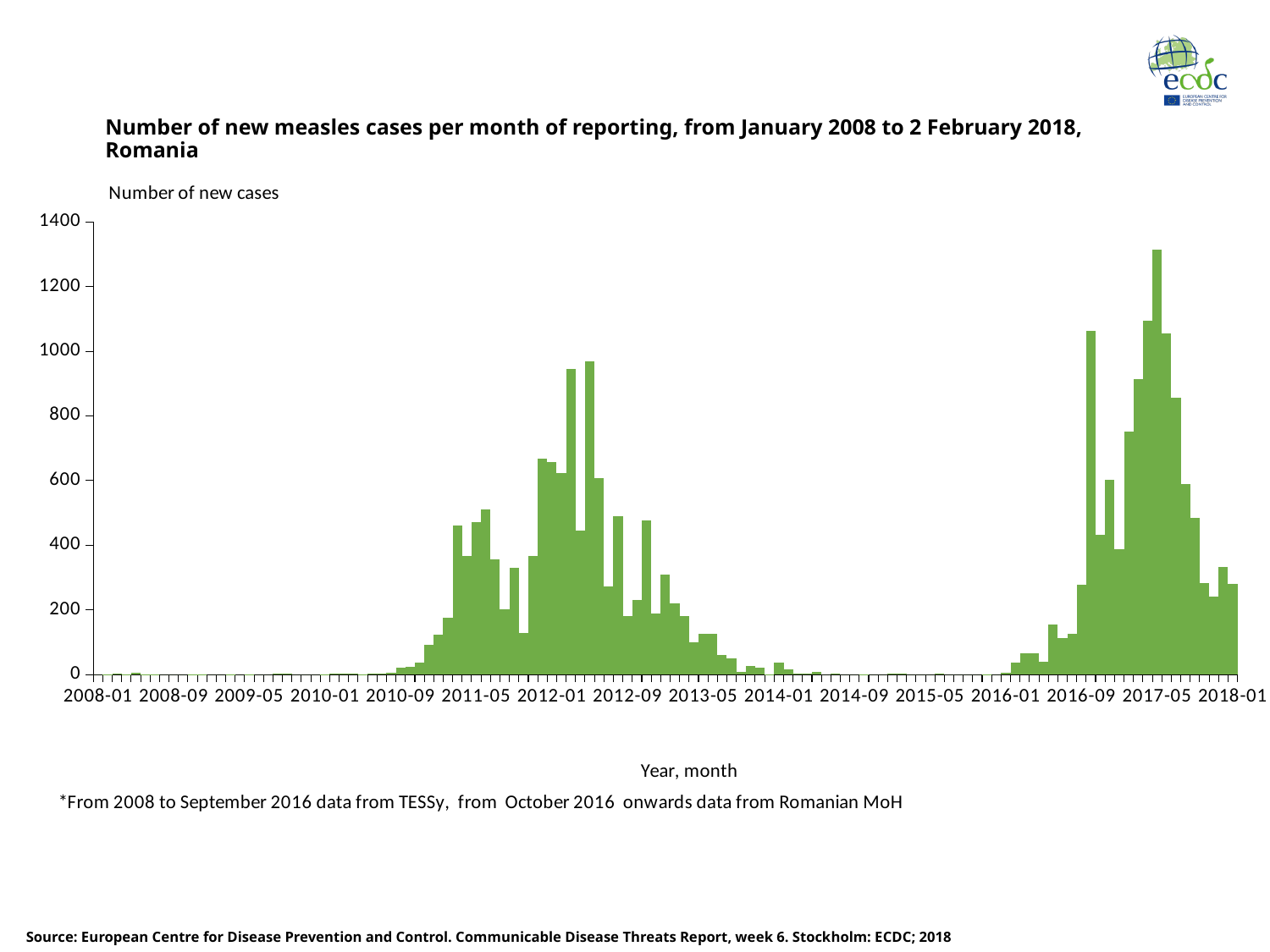
Which has the larger value, 2017-05 or 2012-01? 2017-05 Do the values rise or fall from 2017-05 to 2018-01? fall Which has the larger value, 2018-01 or 2014-01? 2018-01 Around which x-axis label does the highest bar occur? 2017-05 Is the value for 2014-01 greater or less than 200? less What kind of chart is shown on the slide? bar chart Is the value for 2012-01 greater or less than 400? greater What is the title of the chart? Number of new measles cases per month of reporting, from January 2008 to 2 February 2018, Romania Is the value for 2015-05 greater or less than 200? less What is the label of the vertical axis? Number of new cases